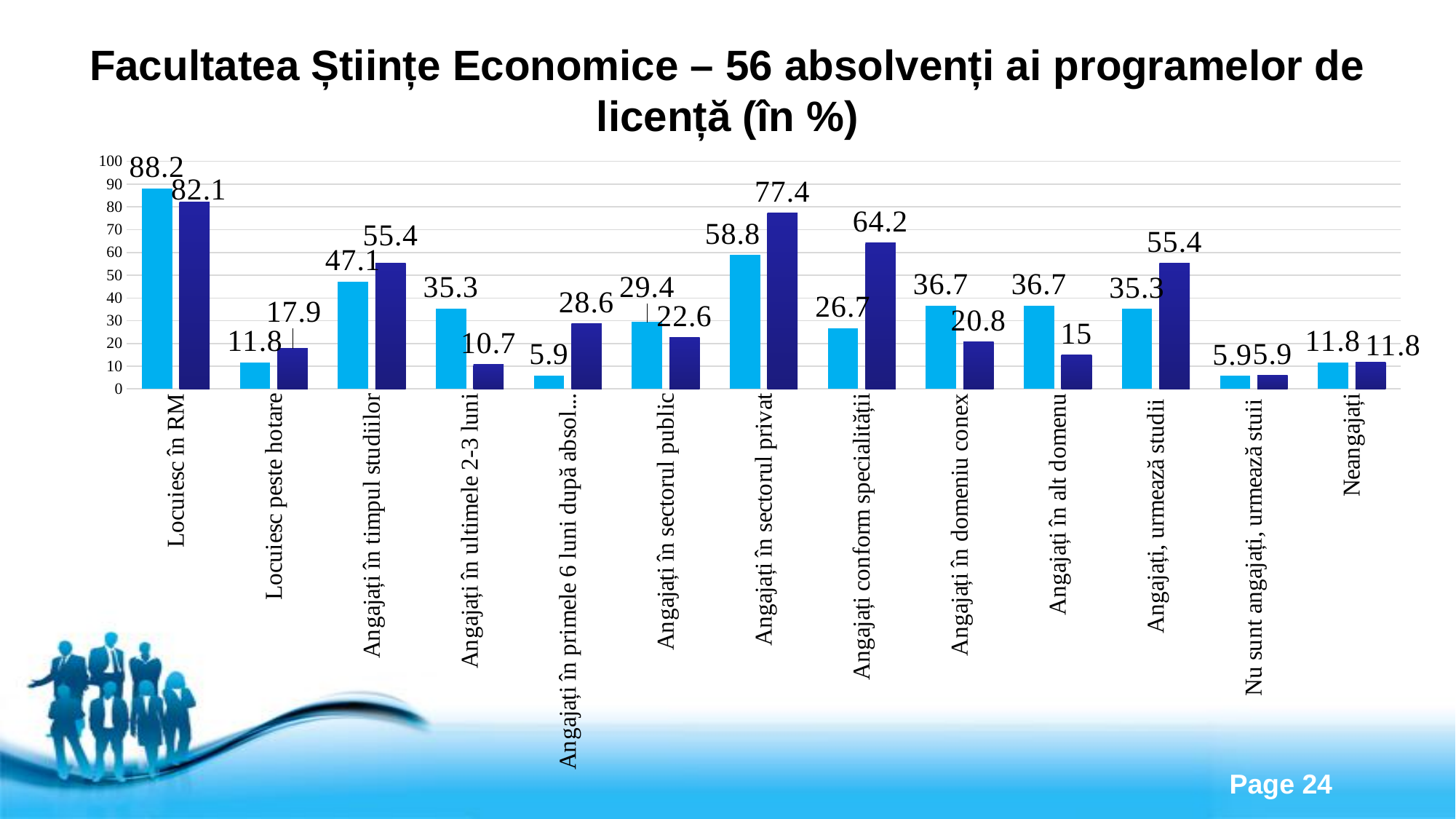
Which category has the lowest dark blue bar? Nu sunt angajați, urmează stuii For "Angajați în domeniu conex", which bar is larger, the light blue or the dark blue? light blue What is the difference between the dark blue and light blue bars for "Angajați conform specialității"? 37.5 What is the dark blue bar value for "Angajați conform specialității"? 64.2 What is the dark blue bar value for "Angajați în sectorul privat"? 77.4 What is the light blue bar value for "Angajați în sectorul public"? 29.4 What type of chart is shown on the slide? bar chart How many categories are shown on the x axis? 13 What is the difference between the light blue and dark blue bars for "Angajați în ultimele 2-3 luni"? 24.6 What is the light blue bar value for "Locuiesc în RM"? 88.2 Is the dark blue bar for "Angajați în timpul studiilor" greater or less than 50? greater Which category has the highest light blue bar? Locuiesc în RM